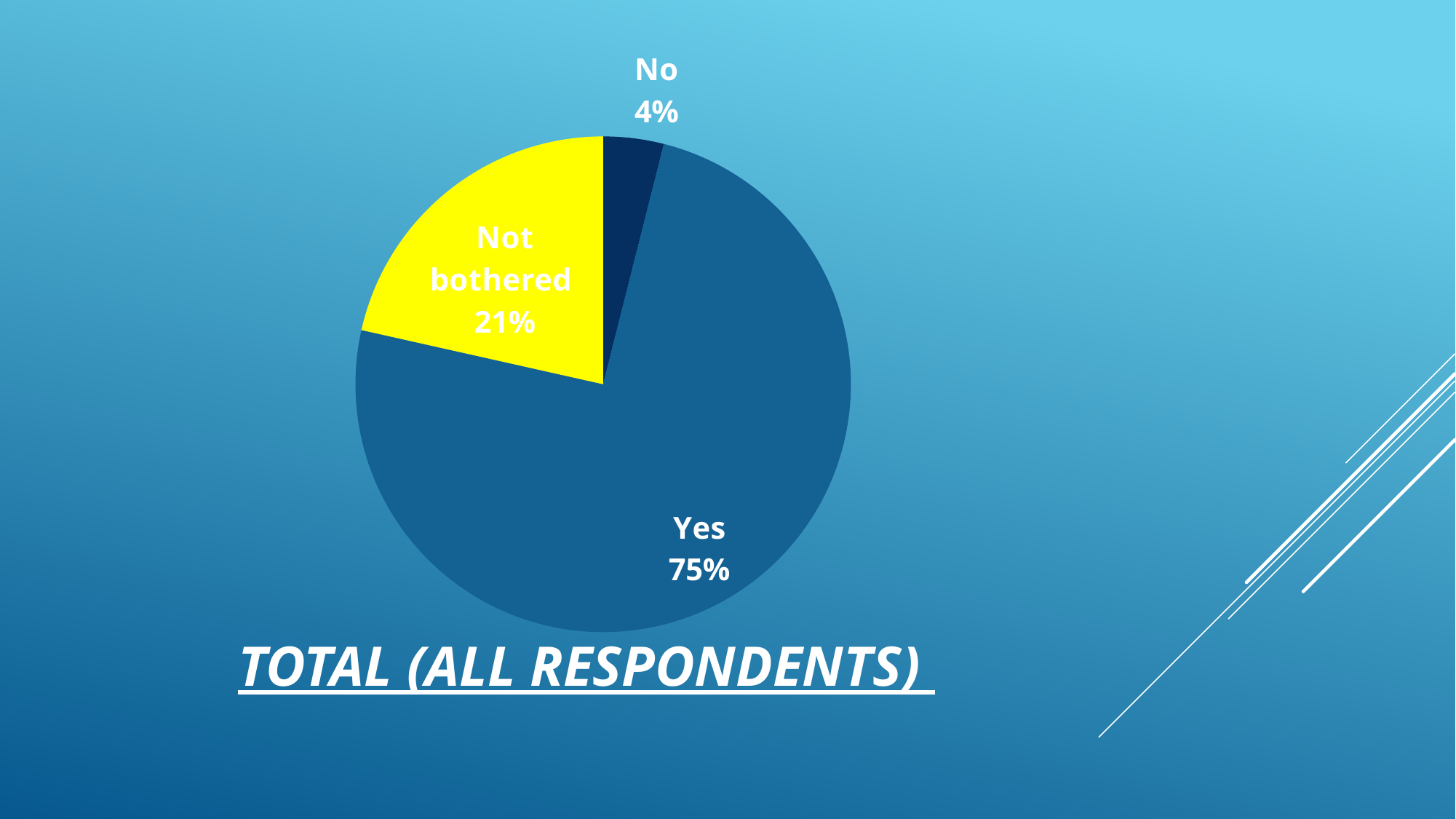
Which is larger, the share for "Not bothered" or the share for "No"? Not bothered How many slices does the pie chart have? 3 Which slice of the pie is coloured yellow? Not bothered What percentage of respondents were "Not bothered"? 21% Which response has the largest share of the pie? Yes What percentage of respondents answered "Yes"? 75% What percentage of respondents answered "No"? 4% What is the title shown below the pie chart? TOTAL (ALL RESPONDENTS) Which response has the smallest share of the pie? No What is the difference in percentage points between "Yes" and "Not bothered"? 54 What kind of chart is shown on the slide? pie chart What is the difference in percentage points between "Not bothered" and "No"? 17